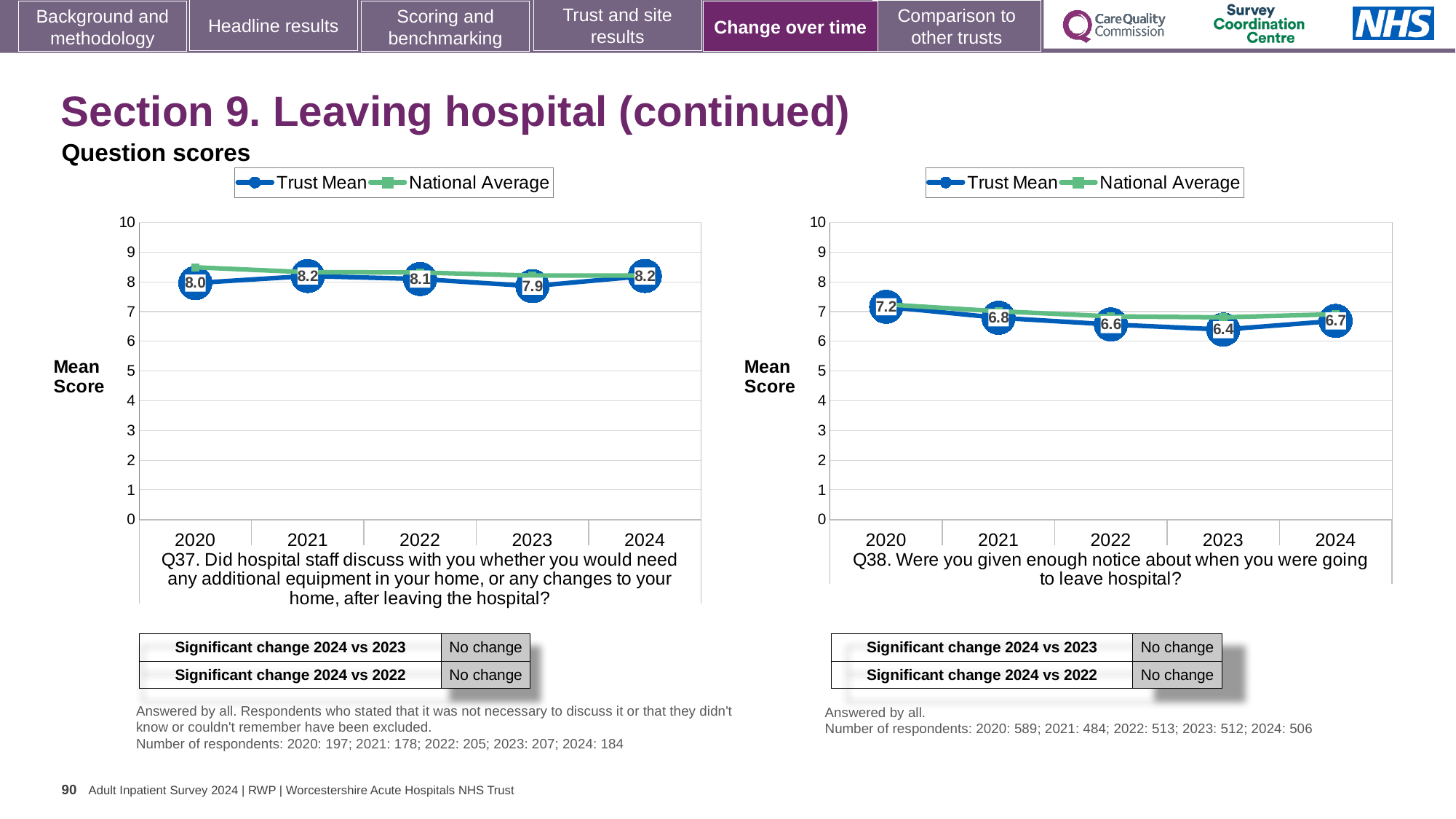
On the Q38 chart (right), what is the difference between the Trust Mean scores for 2020 and 2023? 0.8 On the Q37 chart (left), what is the difference between the Trust Mean scores for 2024 and 2023? 0.3 How many series does the legend of the Q37 chart (left) list? 2 On the Q37 chart (left), is the Trust Mean score for 2021 larger or smaller than the Trust Mean score for 2023? larger What kind of chart is the Q38 chart (right)? line chart On the Q38 chart (right), which year has the lowest Trust Mean score? 2023 On the Q38 chart (right), what is the Trust Mean score for 2024? 6.7 On the Q38 chart (right), is the Trust Mean value for 2022 greater or less than 7? less On the Q38 chart (right), what is the Trust Mean score for 2020? 7.2 On the Q37 chart (left), what is the Trust Mean score for 2020? 8.0 On the Q37 chart (left), what is the Trust Mean score for 2023? 7.9 On the Q38 chart (right), which year has the highest Trust Mean score? 2020